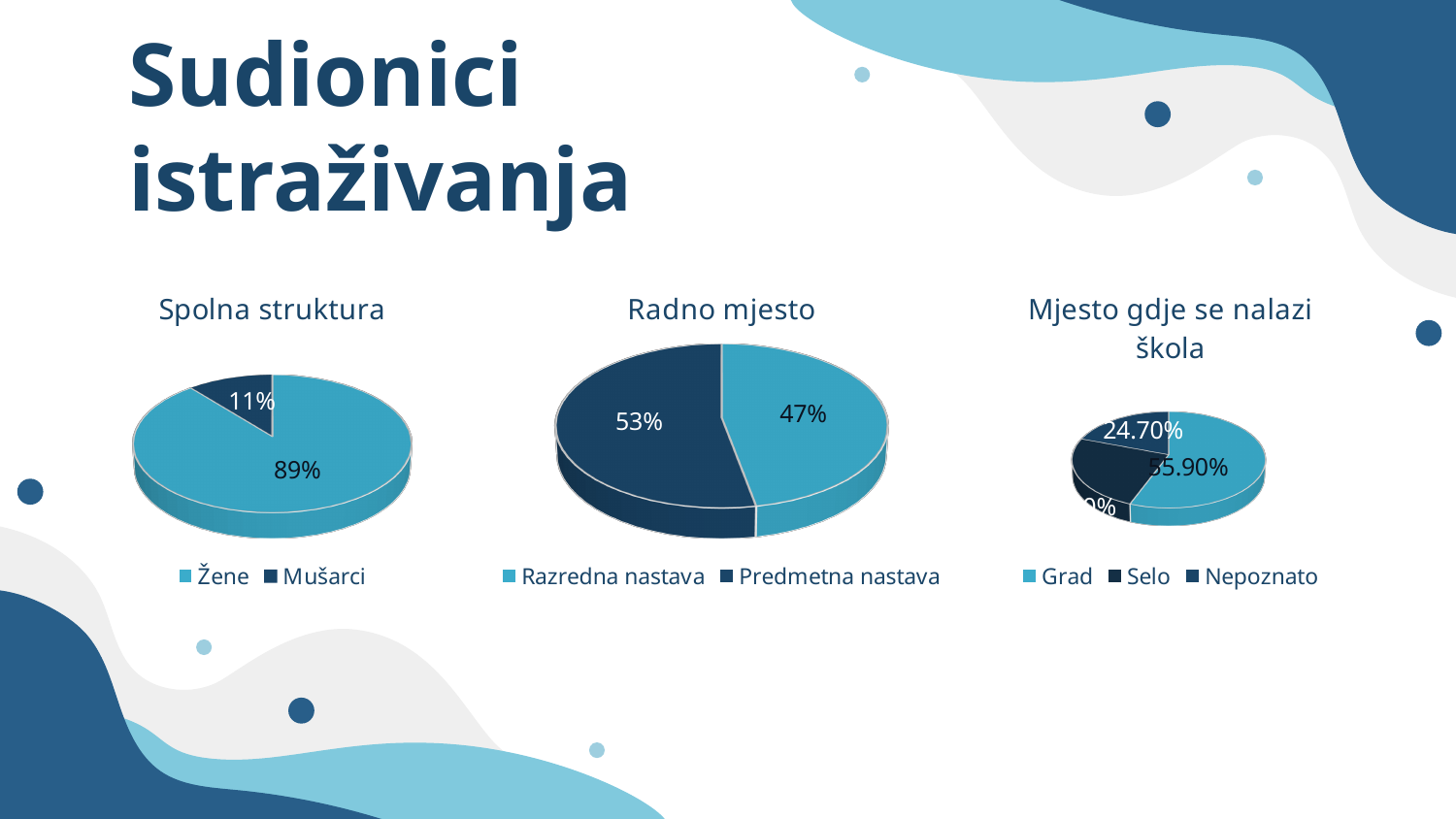
In the 'Spolna struktura' chart, what share is shown for Žene? 89% In the 'Spolna struktura' chart, what share is shown for Mušarci? 11% In the 'Mjesto gdje se nalazi škola' chart, what share is shown for Grad? 55.90% In the 'Mjesto gdje se nalazi škola' chart, how many categories does the legend list? 3 In the 'Radno mjesto' chart, what share is shown for Razredna nastava? 47% In the 'Radno mjesto' chart, which is larger: Razredna nastava or Predmetna nastava? Predmetna nastava What type of chart is the 'Radno mjesto' chart? Pie chart In the 'Spolna struktura' chart, what is the difference between the shares for Žene and Mušarci? 78% How many charts are shown on the slide? 3 In the 'Spolna struktura' chart, which category has the larger share? Žene In the 'Mjesto gdje se nalazi škola' chart, what share is shown for Selo? 24.70% In the 'Radno mjesto' chart, what share is shown for Predmetna nastava? 53%